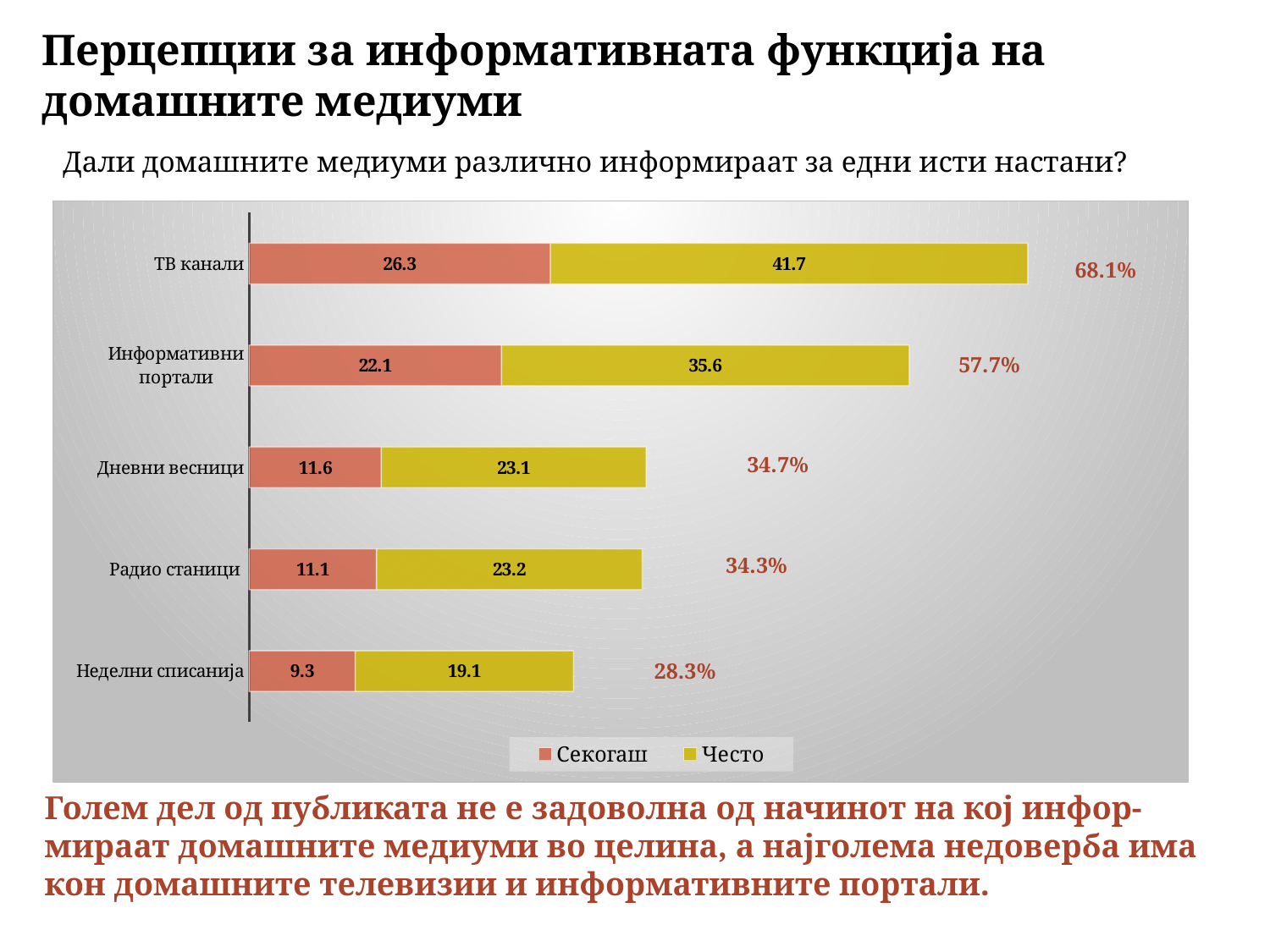
What percentage label is shown next to the bar for Дневни весници? 34.7% How many series does the legend list? 2 What is the value of Често for Информативни портали? 35.6 What is the total of the stacked bar for Информативни портали? 57.7 Which category has the highest value for Често? ТВ канали What is the value of Секогаш for Неделни списанија? 9.3 What is the difference between the Често values for ТВ канали and Дневни весници? 18.6 How many categories are shown in the chart? 5 Which is larger: the Секогаш value for Информативни портали or for Дневни весници? Информативни портали Which category has the lowest value for Секогаш? Неделни списанија What is the value of Секогаш for ТВ канали? 26.3 What is the value of Често for Радио станици? 23.2